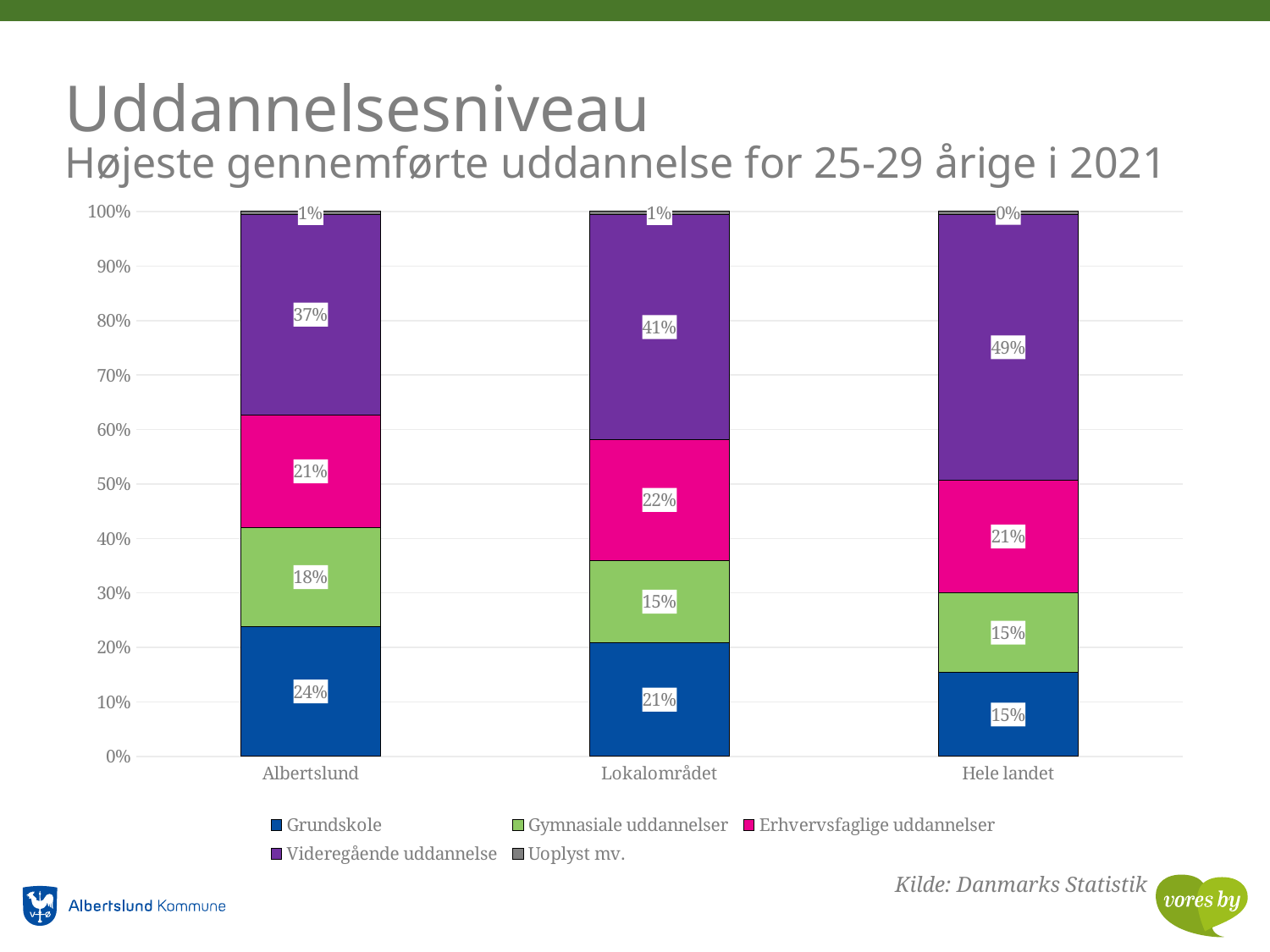
What is the Uoplyst mv. share for Hele landet? 0% Which category has the highest Videregående uddannelse share? Hele landet Which is larger: the Grundskole share for Albertslund or for Lokalområdet? Albertslund What kind of chart is shown on the slide? Stacked bar chart How many series does the legend list? 5 What is the Grundskole share for Albertslund? 24% What is the Videregående uddannelse share for Hele landet? 49% What is the difference between the Videregående uddannelse share for Hele landet and for Albertslund? 12% Which category has the lowest Grundskole share? Hele landet What is the Erhvervsfaglige uddannelser share for Lokalområdet? 22% What is the Gymnasiale uddannelser share for Albertslund? 18% How many categories are shown on the x axis? 3